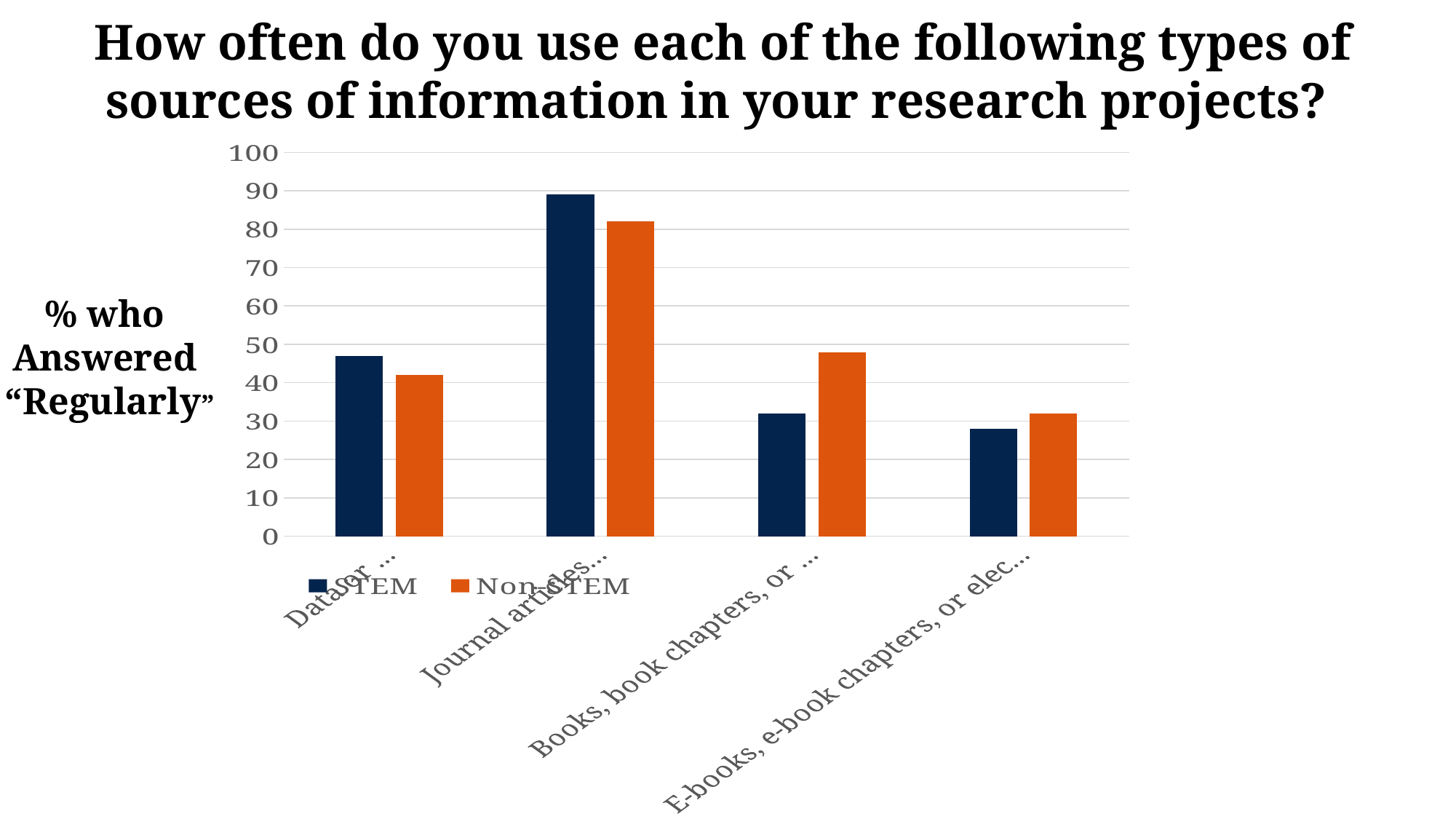
Is the STEM value for the E-books category greater or less than 30? less Is the Non-STEM value for the Books, book chapters category greater or less than 40? greater Which category has the highest STEM value? Journal articles Is the STEM value for the Journal articles category greater or less than 80? greater How many categories are shown on the x axis? 4 For the Journal articles category, which is larger: the STEM value or the Non-STEM value? STEM For the Books, book chapters category, which is larger: the STEM value or the Non-STEM value? Non-STEM What does the y axis of the chart represent? % who Answered "Regularly" What kind of chart is shown on the slide? bar chart Which category has the highest Non-STEM value? Journal articles Which category has the lowest STEM value? E-books, e-book chapters, or electronic... How many series does the legend list? 2